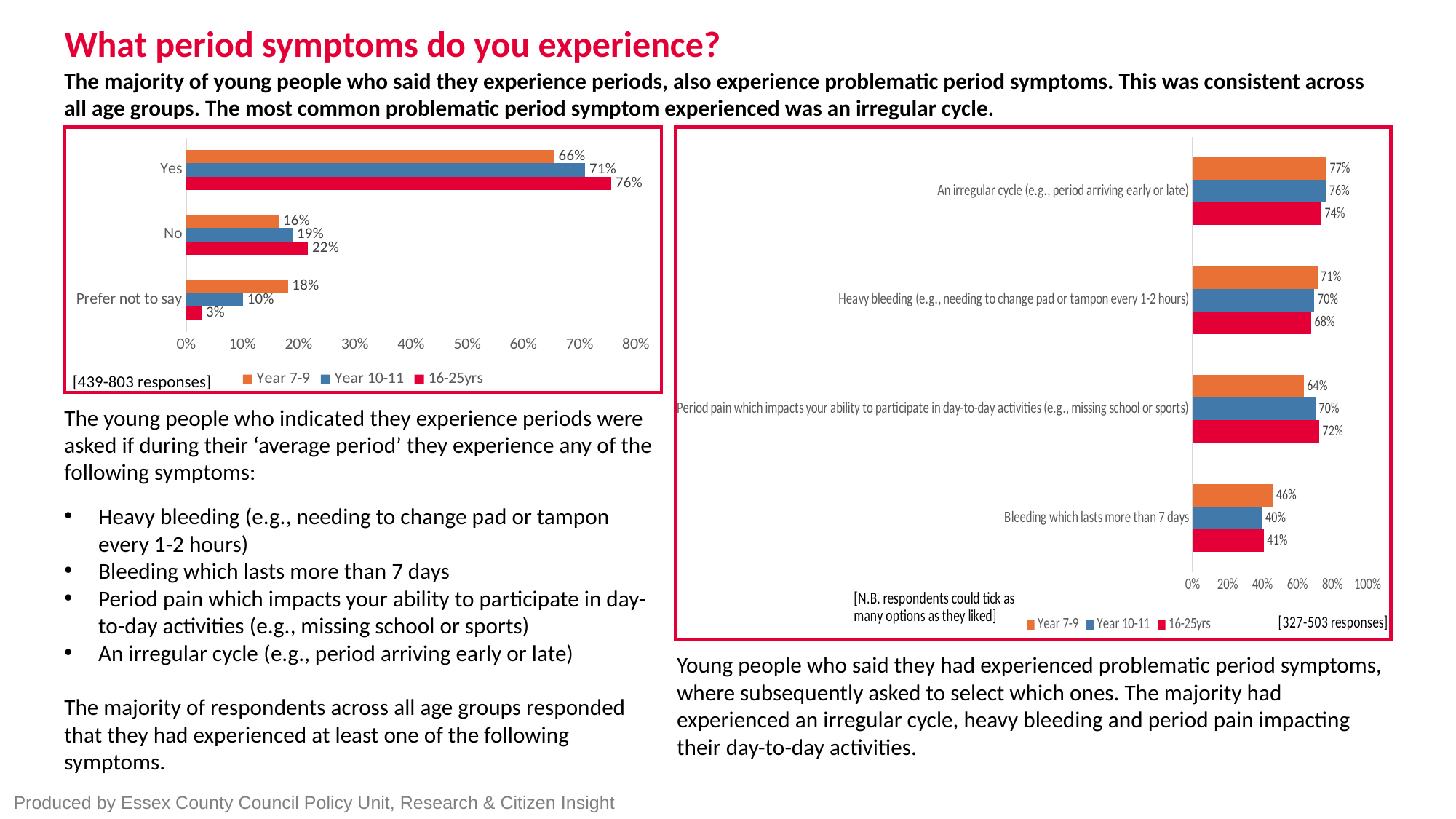
In the right chart, what is the difference between the Year 7-9 and Year 10-11 values for 'Bleeding which lasts more than 7 days'? 6% In the left chart, what is the value for Year 10-11 in the 'Yes' category? 71% In the right chart, which symptom has the lowest value for Year 10-11? Bleeding which lasts more than 7 days In the left chart, what is the value for 16-25yrs in the 'Prefer not to say' category? 3% In the left chart, what is the difference between the 16-25yrs and Year 7-9 values for 'Yes'? 10% In the left chart, how many response categories are shown? 3 In the right chart, is the Year 7-9 value for 'Period pain which impacts your ability to participate in day-to-day activities' larger or smaller than the 16-25yrs value? smaller In the right chart, what is the 16-25yrs value for 'Bleeding which lasts more than 7 days'? 41% What type of chart is the right chart? bar chart In the left chart, how many series does the legend list? 3 In the right chart, what is the Year 7-9 value for 'An irregular cycle (e.g., period arriving early or late)'? 77% In the left chart, which age group has the highest value for 'No'? 16-25yrs